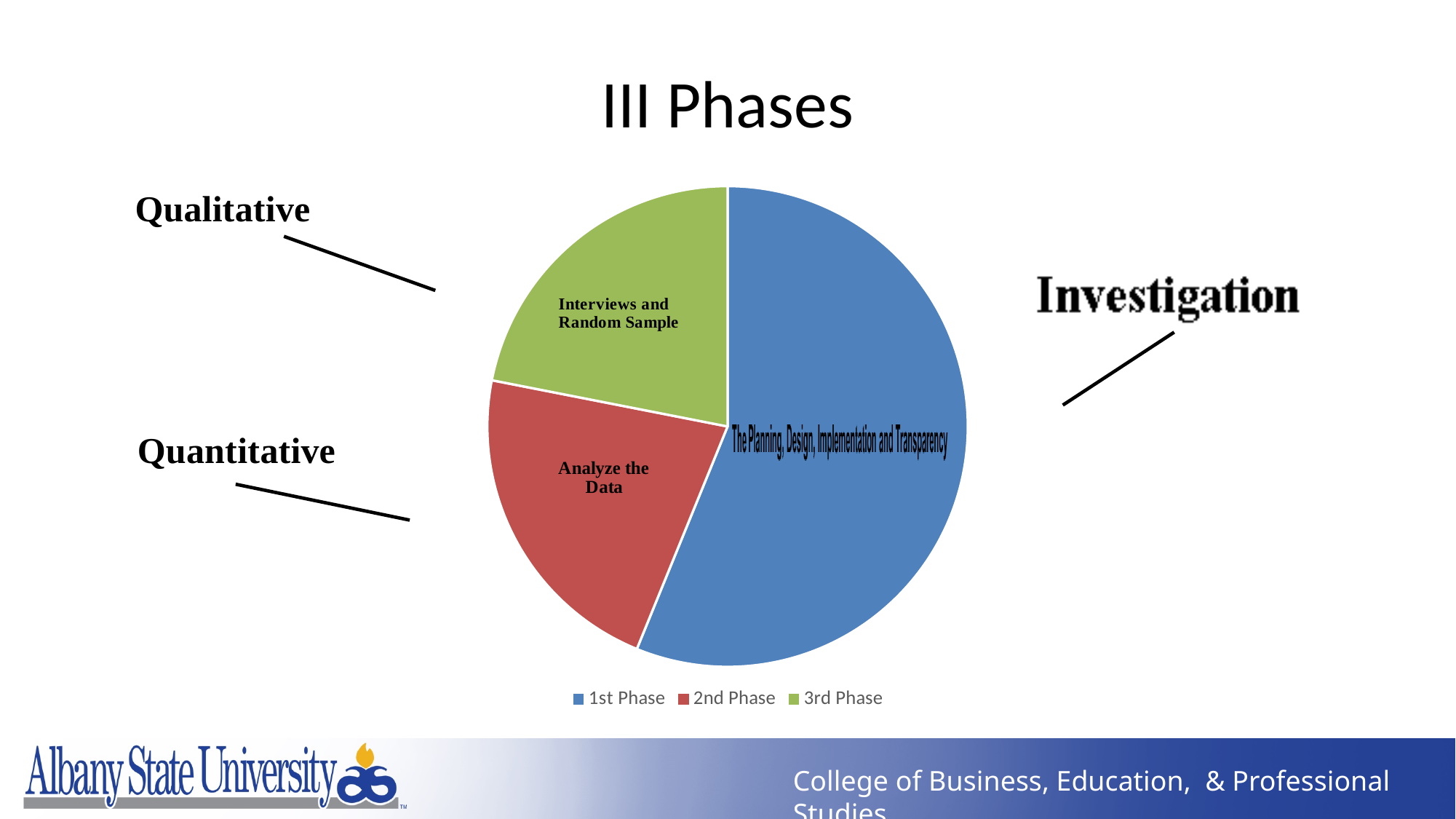
Which slice is larger, 1st Phase or 2nd Phase? 1st Phase How many entries does the legend of the pie chart list? 3 What is the title of the slide containing the pie chart? III Phases What colour is the 2nd Phase slice in the pie chart? red Which phase has the largest slice in the pie chart? 1st Phase What text label appears inside the blue (1st Phase) slice? The Planning, Design, Implementation and Transparency What kind of chart is shown on the slide? pie chart Which slice is larger, 3rd Phase or 1st Phase? 1st Phase How many slices does the pie chart have? 3 What text label appears inside the green (3rd Phase) slice? Interviews and Random Sample What text label appears inside the red (2nd Phase) slice? Analyze the Data